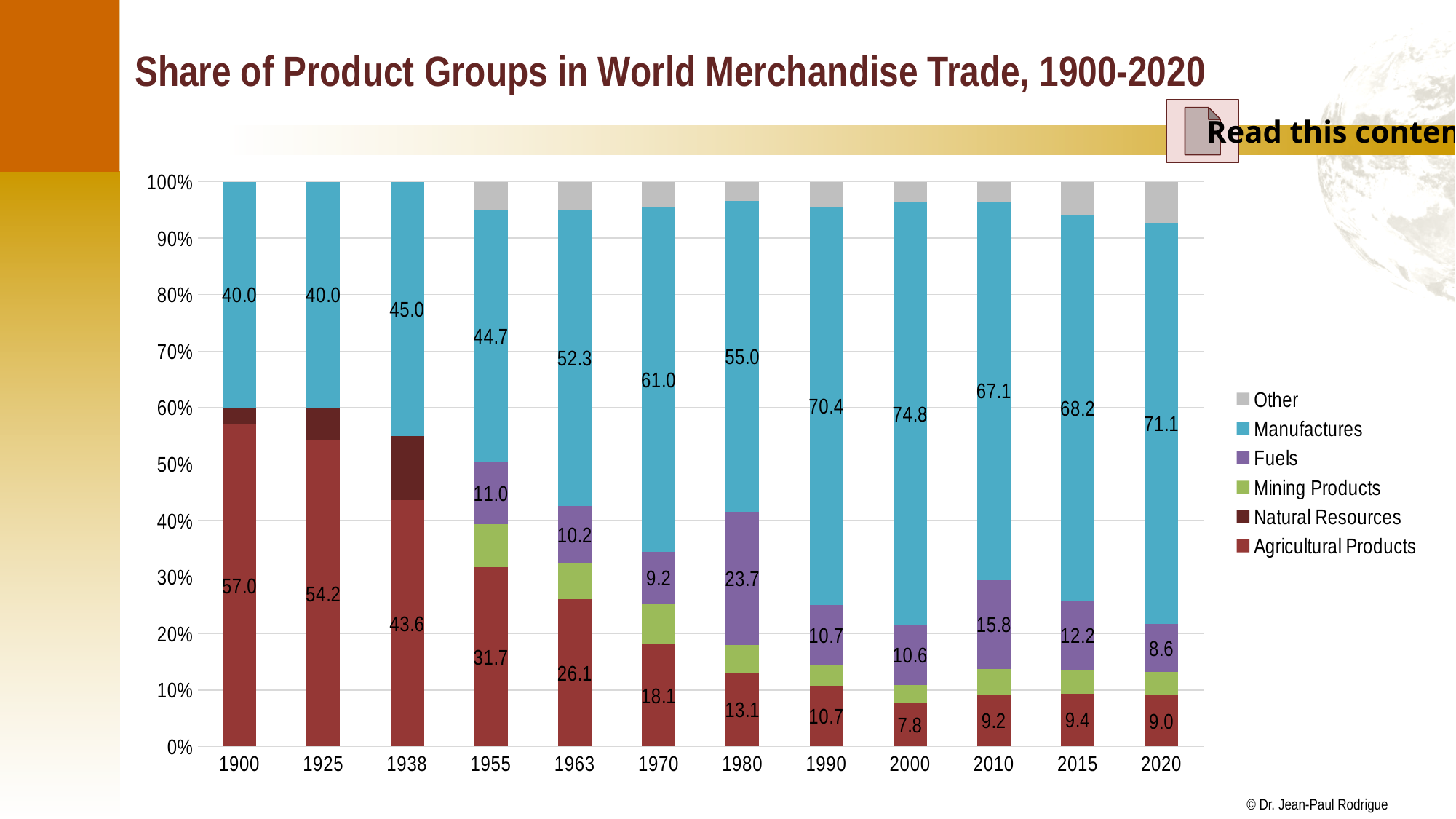
In which year is the Agricultural Products share lowest? 2000 What kind of chart is shown on the slide? Stacked bar chart Which is larger, the Fuels value in 1980 or in 2010? 1980 What is the value for Fuels in 1980? 23.7 What is the value for Manufactures in 2000? 74.8 How many series does the legend list? 6 What is the value for Agricultural Products in 1900? 57.0 What is the difference between the Agricultural Products value in 1900 and in 2020? 48.0 Does the Agricultural Products share generally rise or fall from 1900 to 2020? Fall In which year is the Manufactures share highest? 2000 How many years are shown on the x axis? 12 In which year is the Fuels share highest? 1980